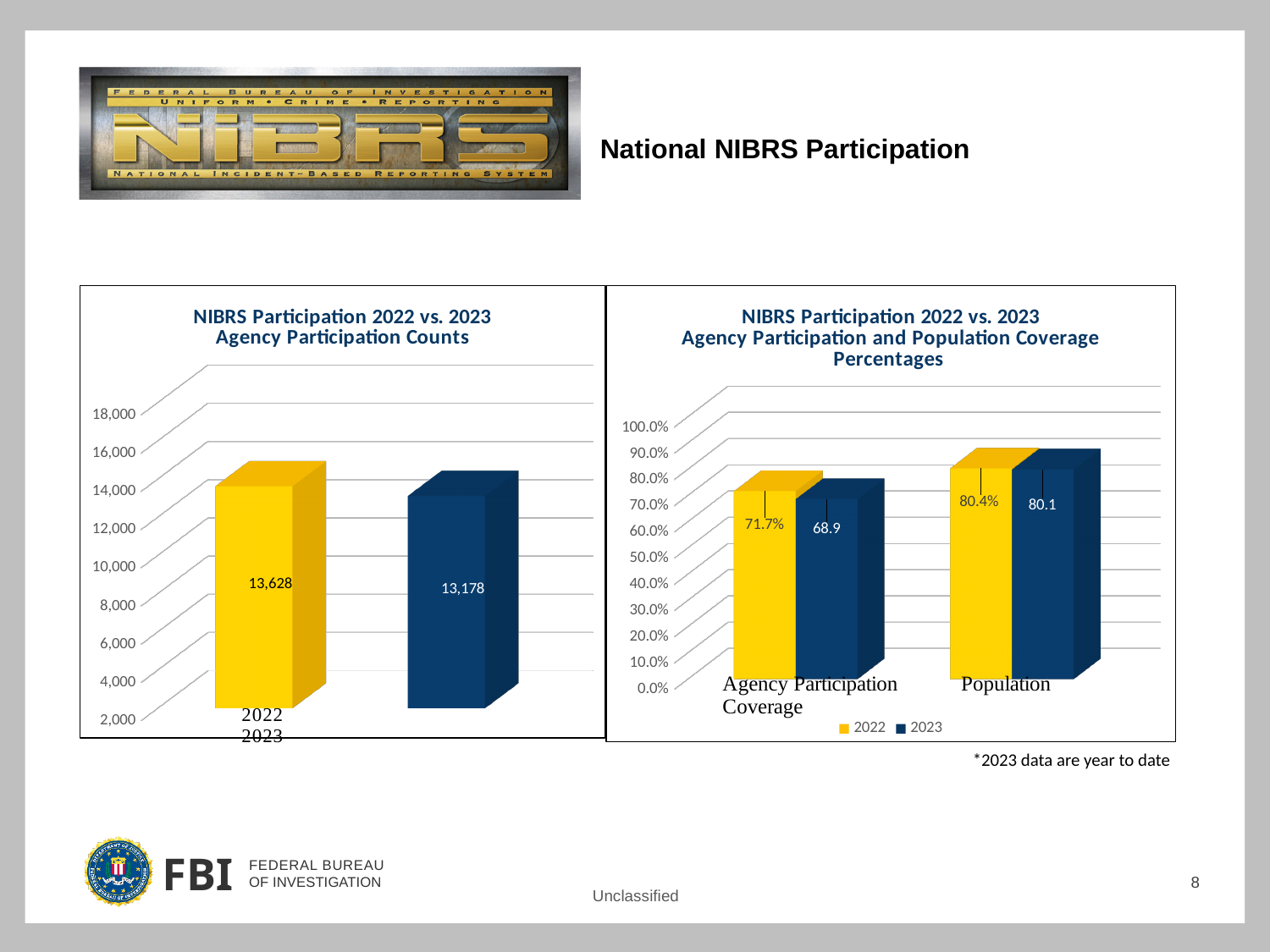
In the right chart (Percentages), how many series does the legend list? 2 In the right chart (Percentages), what is the 2023 value for Population? 80.1 In the left chart (Agency Participation Counts), what is the difference between the 2022 and 2023 values? 450 In the left chart (Agency Participation Counts), which year has the higher count? 2022 In the right chart (Percentages), which is larger for Agency Participation Coverage, the 2022 value or the 2023 value? 2022 What kind of chart is the right chart (Percentages)? bar chart In the right chart (Percentages), what is the 2022 value for Agency Participation Coverage? 71.7% In the left chart (Agency Participation Counts), what is the value for 2022? 13,628 In the right chart (Percentages), what is the 2022 value for Population? 80.4% In the right chart (Percentages), what is the 2023 value for Agency Participation Coverage? 68.9 In the left chart (Agency Participation Counts), do the values rise or fall from 2022 to 2023? fall In the left chart (Agency Participation Counts), what is the value for 2023? 13,178